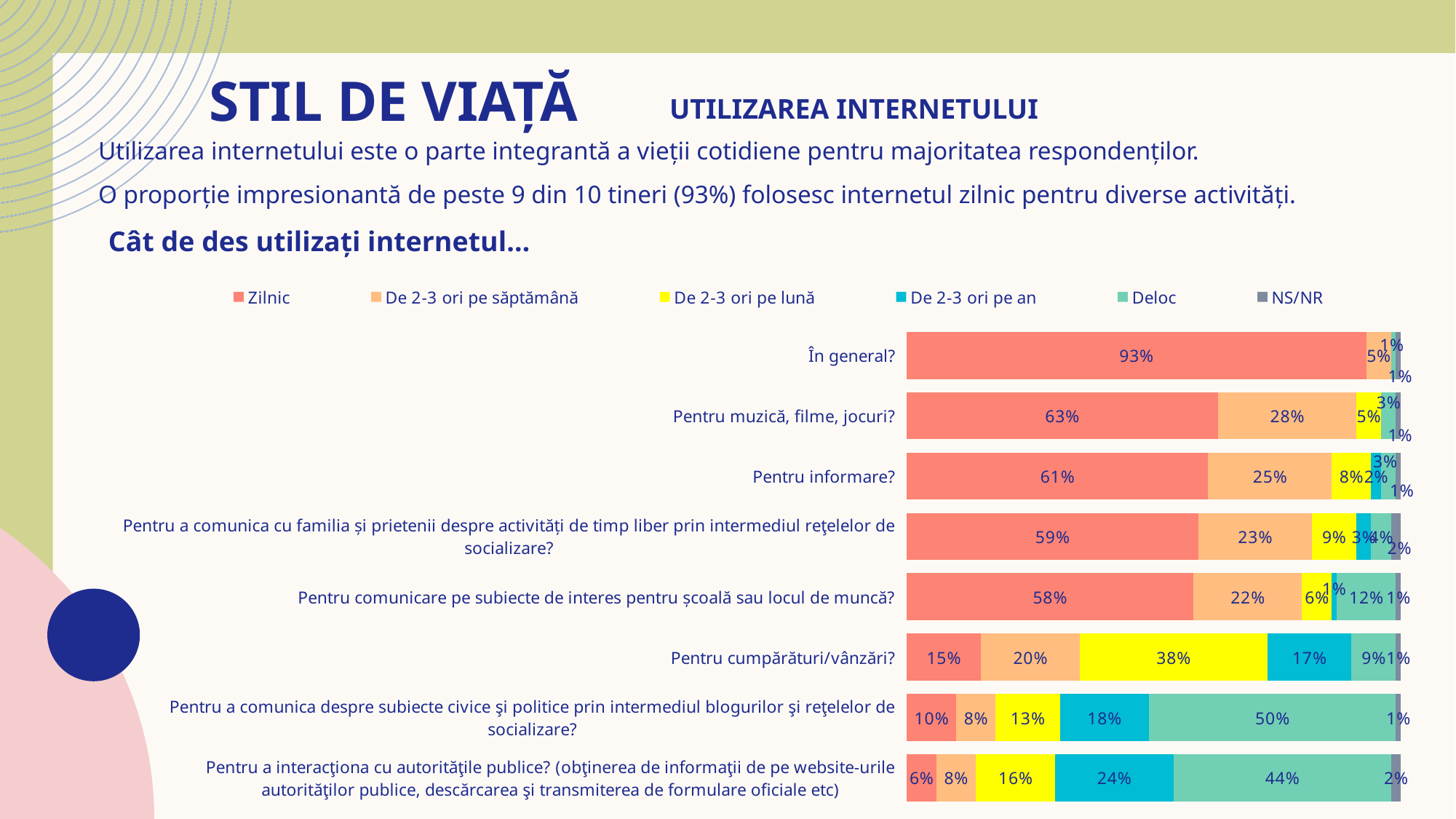
What is the Deloc value for "Pentru a comunica despre subiecte civice şi politice prin intermediul blogurilor şi reţelelor de socializare?"? 50% What is the Zilnic value for "În general?"? 93% What is the difference between the Zilnic values for "Pentru muzică, filme, jocuri?" and "Pentru informare?"? 2% What is the Zilnic value for "Pentru cumpărături/vânzări?"? 15% What kind of chart is shown on the slide? stacked bar chart How many categories (questions) are plotted in the chart? 8 How many series does the legend list? 6 Which category has the highest Zilnic value? În general? What is the De 2-3 ori pe an value for "Pentru a interacţiona cu autorităţile publice?"? 24% Which is larger: the De 2-3 ori pe lună value for "Pentru cumpărături/vânzări?" or the De 2-3 ori pe lună value for "Pentru a comunica despre subiecte civice şi politice"? Pentru cumpărături/vânzări? Which category has the lowest Zilnic value? Pentru a interacţiona cu autorităţile publice? Which legend entry is shown in yellow? De 2-3 ori pe lună